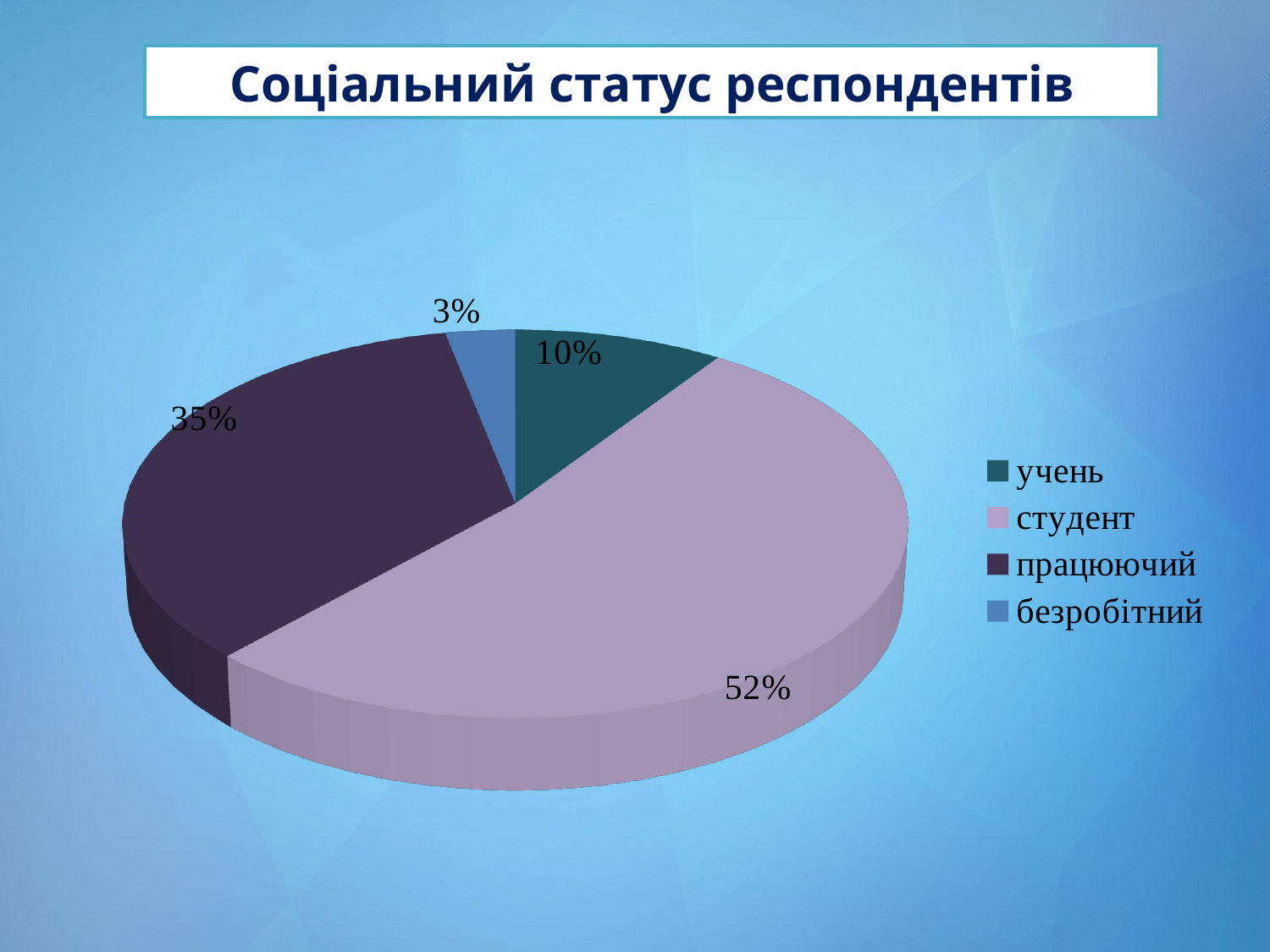
What is the title of the chart? Соціальний статус респондентів Which is larger, the share for учень or the share for безробітний? учень What is the difference in percentage points between студент and працюючий? 17 What share of respondents are учень? 10% Which category has the largest share of the pie? студент What share of respondents are студент? 52% How many categories does the pie chart show? 4 What share of respondents are працюючий? 35% Which category is shown in the light pink colour? студент What kind of chart is shown on the slide? pie chart Which category has the smallest share of the pie? безробітний What share of respondents are безробітний? 3%